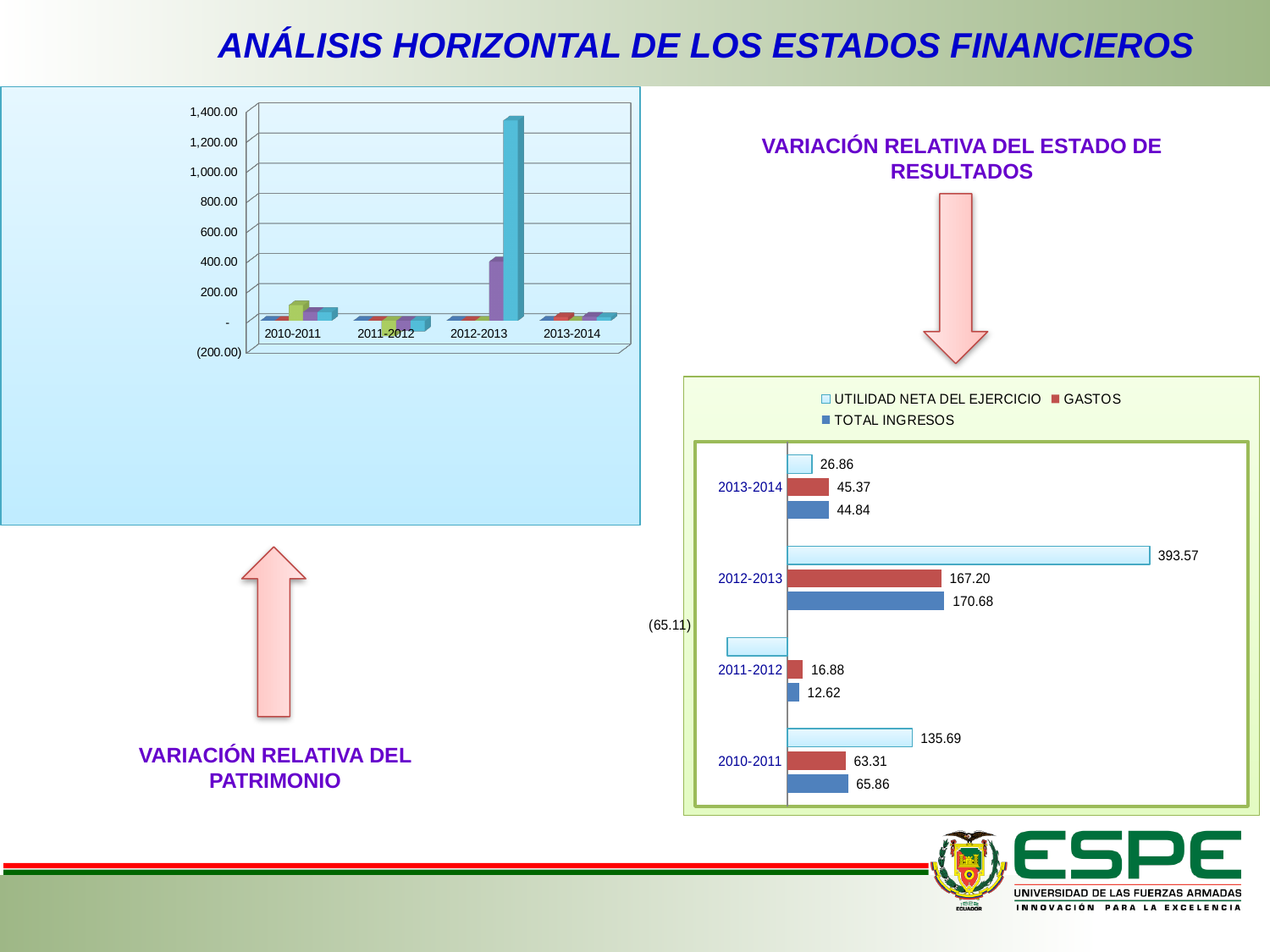
In the VARIACIÓN RELATIVA DEL ESTADO DE RESULTADOS chart, what is the value of GASTOS for 2013-2014? 45.37 In the VARIACIÓN RELATIVA DEL ESTADO DE RESULTADOS chart, which is larger for 2010-2011: UTILIDAD NETA DEL EJERCICIO or GASTOS? UTILIDAD NETA DEL EJERCICIO In the VARIACIÓN RELATIVA DEL PATRIMONIO chart, is the tallest bar in 2012-2013 greater or less than 1,000.00? greater What kind of chart is the VARIACIÓN RELATIVA DEL ESTADO DE RESULTADOS chart? Bar chart In the VARIACIÓN RELATIVA DEL ESTADO DE RESULTADOS chart, what is the value of TOTAL INGRESOS for 2010-2011? 65.86 In the VARIACIÓN RELATIVA DEL ESTADO DE RESULTADOS chart, what is the value of UTILIDAD NETA DEL EJERCICIO for 2012-2013? 393.57 In the VARIACIÓN RELATIVA DEL ESTADO DE RESULTADOS chart, what is the value of UTILIDAD NETA DEL EJERCICIO for 2011-2012? (65.11) How many series does the legend of the VARIACIÓN RELATIVA DEL ESTADO DE RESULTADOS chart list? 3 How many periods are shown on the x axis of the VARIACIÓN RELATIVA DEL PATRIMONIO chart? 4 In the VARIACIÓN RELATIVA DEL ESTADO DE RESULTADOS chart, which period has the lowest GASTOS value? 2011-2012 In the VARIACIÓN RELATIVA DEL ESTADO DE RESULTADOS chart, what is the difference between TOTAL INGRESOS and GASTOS for 2012-2013? 3.48 In the VARIACIÓN RELATIVA DEL ESTADO DE RESULTADOS chart, which period has the highest TOTAL INGRESOS value? 2012-2013